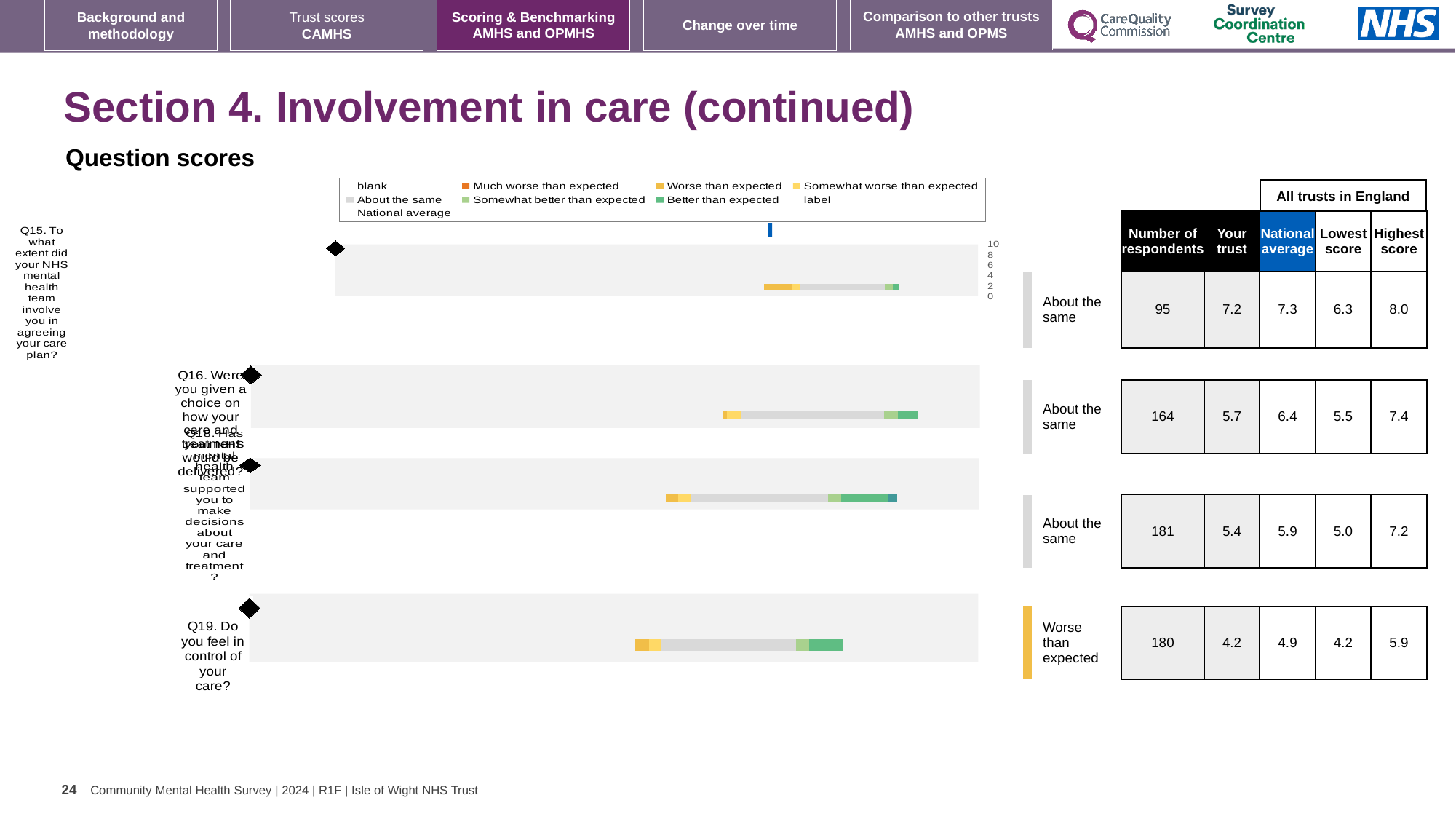
How many respondents answered Q19 (Do you feel in control of your care?)? 180 For Q16, what is the difference between the national average and the 'Your trust' score? 0.7 What benchmark category is shown for Q19? Worse than expected For Q19, which is larger: the 'Your trust' score or the national average? National average What is the national average score for Q16 (choice on how care and treatment would be delivered)? 6.4 Which question has the highest 'Your trust' score on this slide? Q15 How many questions are plotted on this slide? 4 Which question has the lowest 'Your trust' score on this slide? Q19 What is the lowest score among all trusts in England for Q19? 4.2 What is the 'Your trust' score for Q15 (involving you in agreeing your care plan)? 7.2 What is the highest score among all trusts in England for Q18? 7.2 Which question has the most respondents? Q18